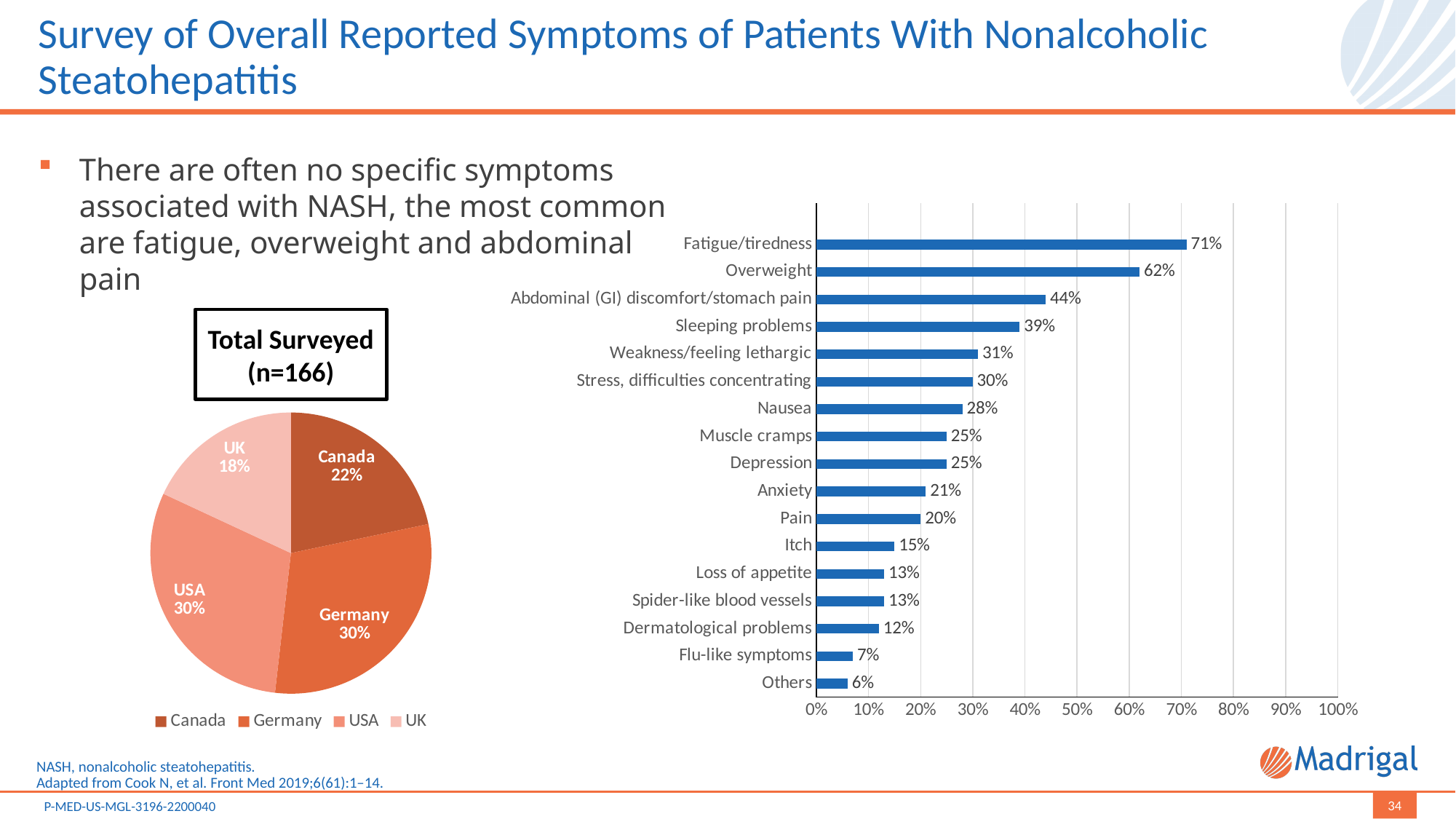
In the bar chart on the right, what percentage of patients reported Sleeping problems? 39% How many entries does the legend of the pie chart titled Total Surveyed (n=166) list? 4 In the pie chart titled Total Surveyed (n=166), what is the combined share of USA and Germany? 60% In the pie chart titled Total Surveyed (n=166), what share of those surveyed were from Canada? 22% In the bar chart on the right, how many symptom categories are shown? 17 In the bar chart on the right, what percentage of patients reported Fatigue/tiredness? 71% In the bar chart on the right, which is larger: the percentage for Nausea or the percentage for Anxiety? Nausea In the bar chart on the right, which symptom has the highest reported percentage? Fatigue/tiredness In the bar chart on the right, what is the difference between the percentages for Overweight and Abdominal (GI) discomfort/stomach pain? 18% In the pie chart titled Total Surveyed (n=166), which country has the smallest share? UK In the bar chart on the right, which symptom has the lowest reported percentage? Others What kind of chart is the chart on the right of the slide? Bar chart